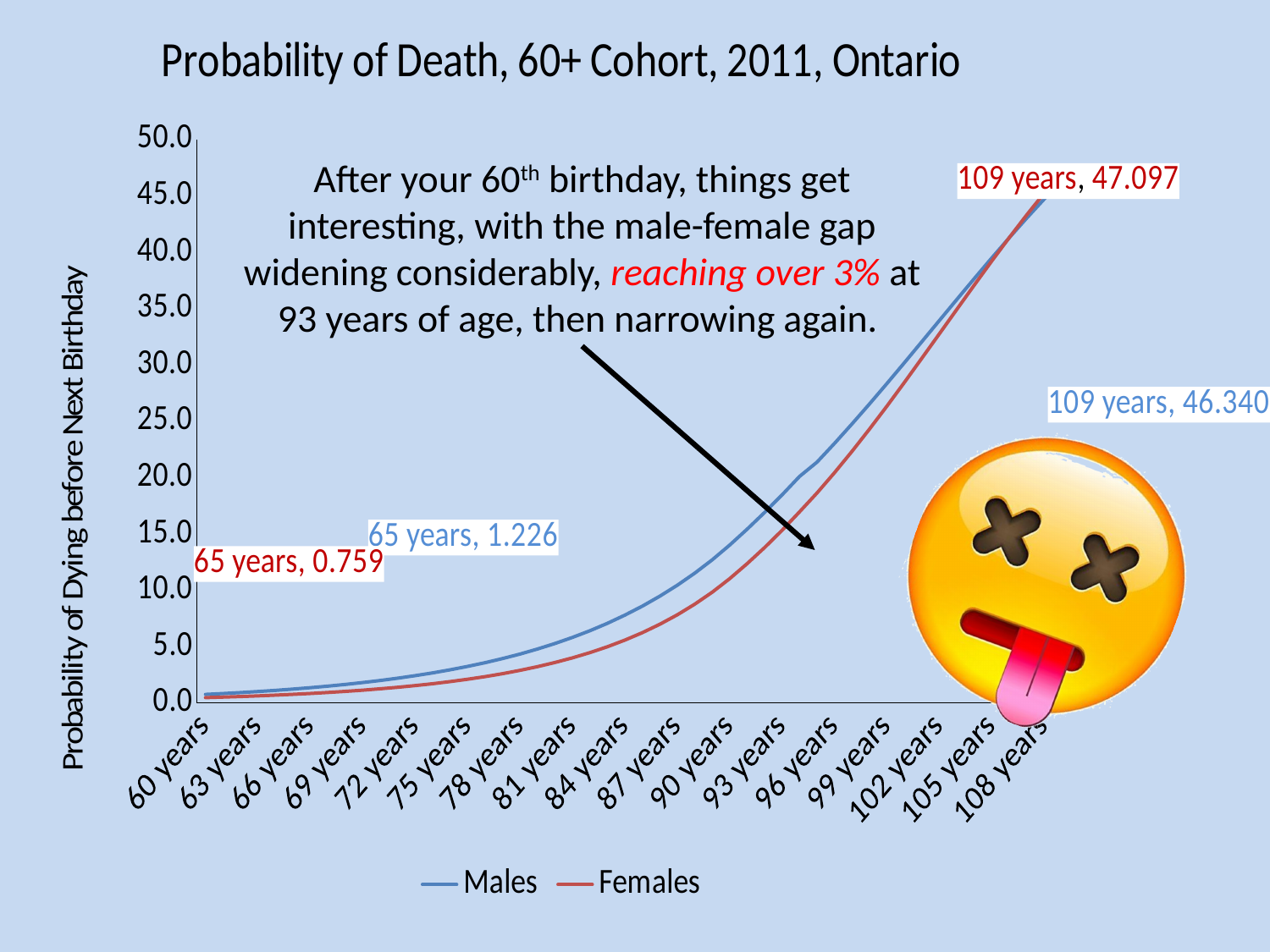
How many series does the legend list? 2 What are the two series named in the legend? Males and Females What is the labelled value for Females at 109 years? 47.097 What is the title of the chart? Probability of Death, 60+ Cohort, 2011, Ontario What is the labelled value for Males at 109 years? 46.340 Is the value for Males at 99 years greater or less than 20.0? greater What is the difference between the Males and Females values at 65 years? 0.467 Do the values for both series rise or fall as age increases along the x axis? rise What is the labelled value for Males at 65 years? 1.226 At 65 years, which series has the larger labelled value, Males or Females? Males What is the labelled value for Females at 65 years? 0.759 What kind of chart is shown on the slide? line chart